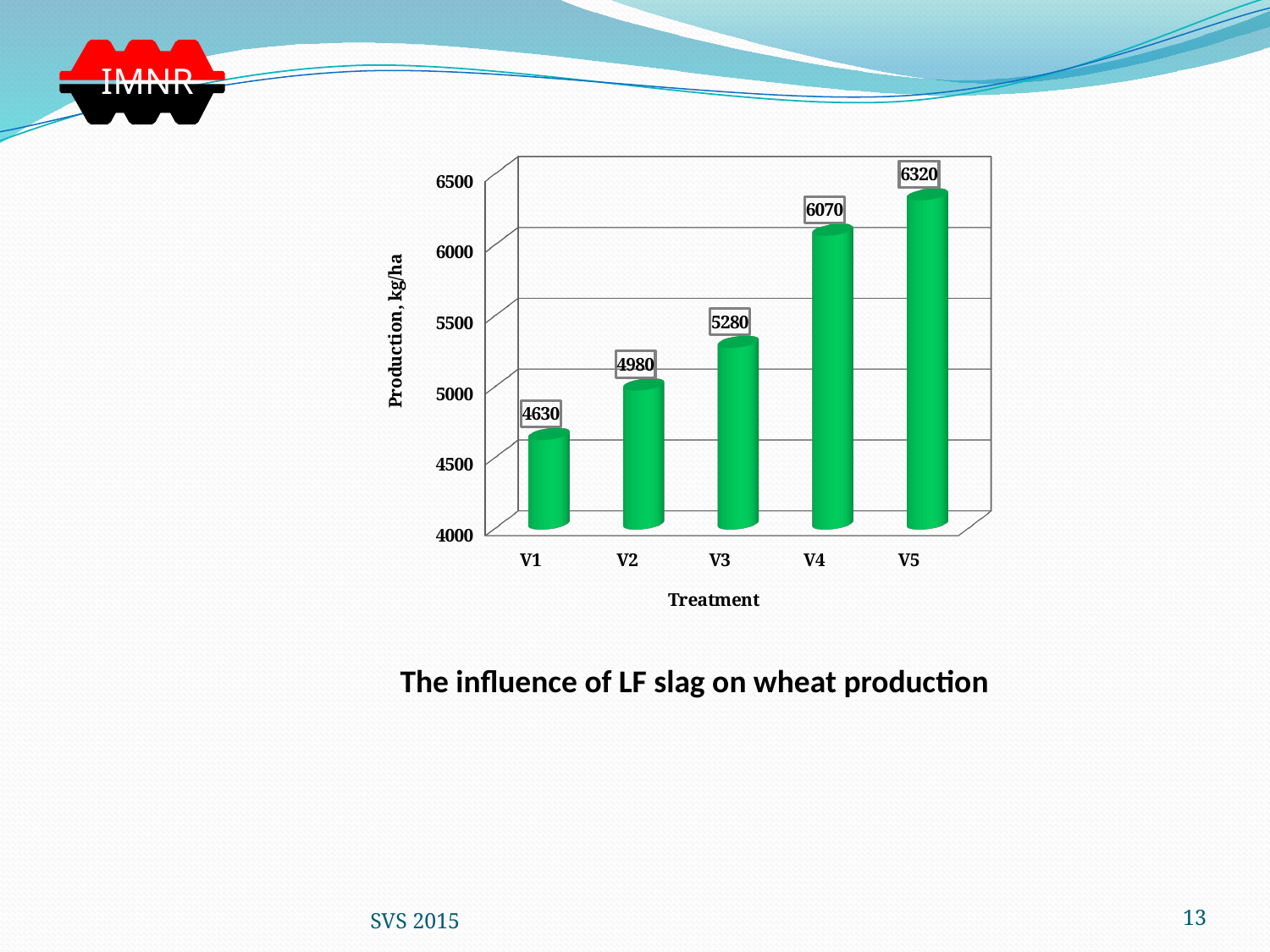
What is the production value for treatment V1? 4630 Which treatment has higher production, V2 or V4? V4 What is the difference in production between V5 and V1? 1690 Which treatment has the lowest production? V1 Which treatment has the highest production? V5 What is the production value for treatment V3? 5280 What is the difference in production between V4 and V3? 790 Do the production values rise or fall from V1 to V5? rise What kind of chart is shown on the slide? bar chart What is the production value for treatment V5? 6320 How many treatments are shown on the x axis? 5 Is the production value for V2 greater or less than 5000? less